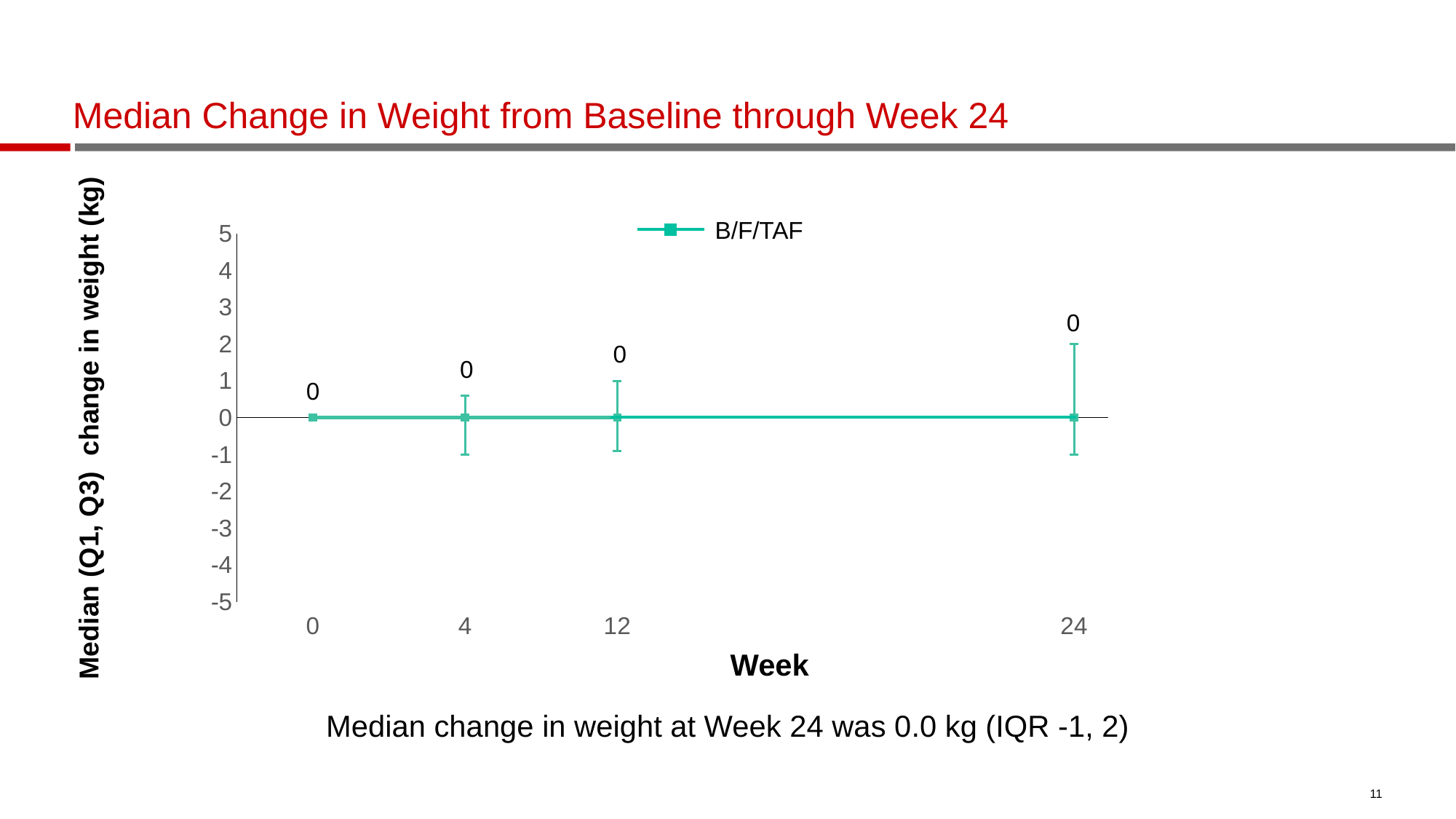
What is the median change in weight at Week 0 (baseline)? 0 How many time points are plotted on the chart? 4 What is the label of the x axis? Week Is the upper end of the error bar at Week 24 greater or less than 1? greater What is the median change in weight at Week 24 for B/F/TAF? 0 What is the median change in weight at Week 4? 0 What is the name of the series shown in the legend? B/F/TAF How many series does the legend list? 1 What is the difference between the median change in weight at Week 24 and at Week 4? 0 What is the median change in weight at Week 12? 0 What kind of chart is shown on the slide? Line chart Do the median values rise, fall, or stay the same from Week 0 to Week 24? Stay the same